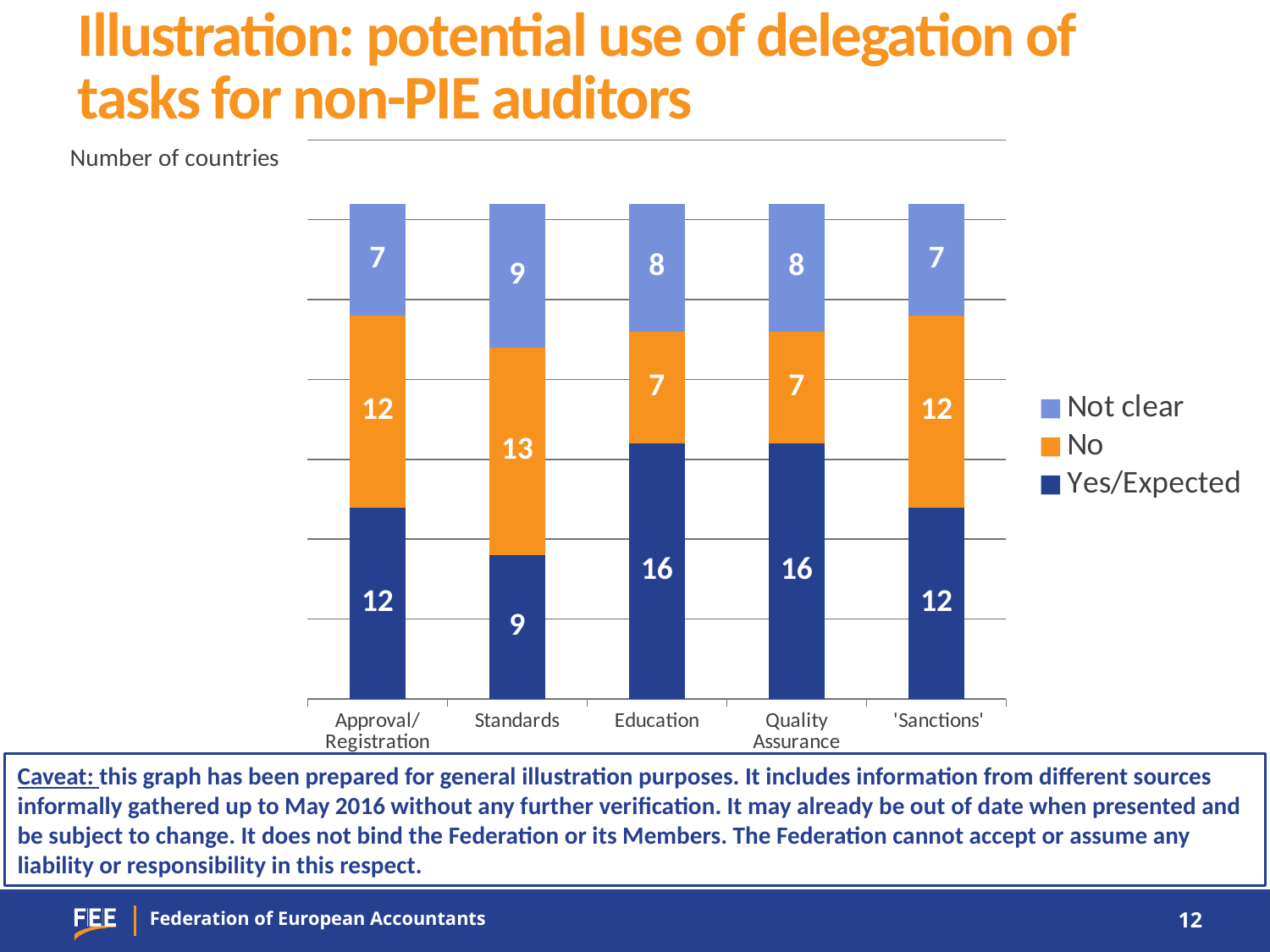
What is the total of the stacked bar for 'Sanctions'? 31 Which series is shown in dark blue in the legend? Yes/Expected Which is larger: the No value for Approval/Registration or the No value for Education? Approval/Registration What type of chart is shown on the slide? Stacked bar chart Which category has the highest No value? Standards What is the difference between the Yes/Expected values for Education and Standards? 7 What is the Not clear value for Quality Assurance? 8 Which category has the lowest Yes/Expected value? Standards What is the Yes/Expected value for Education? 16 What is the No value for Standards? 13 How many categories are shown on the x axis of the chart? 5 How many series does the chart's legend list? 3